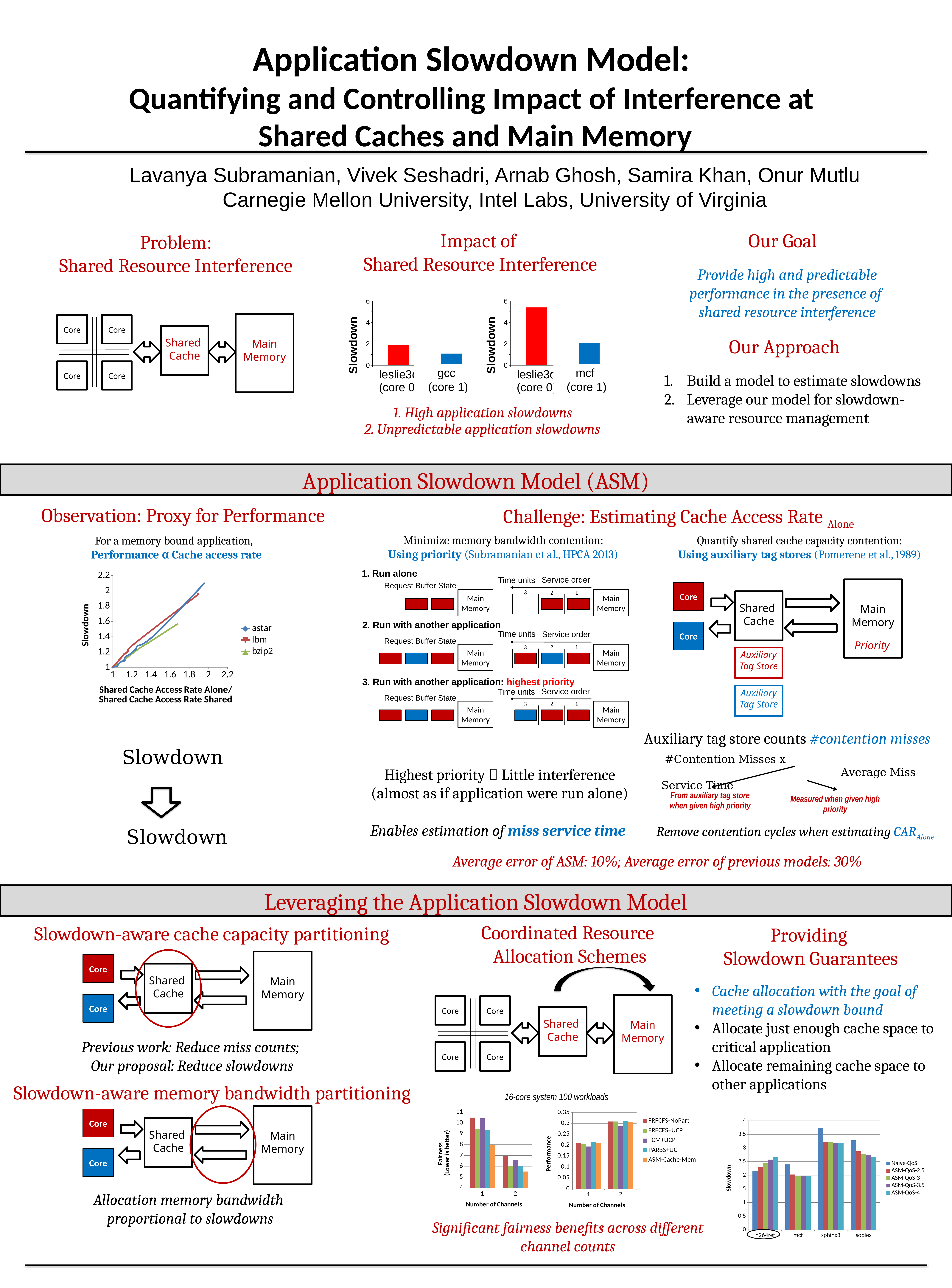
In the 'Providing Slowdown Guarantees' slowdown chart, which application has the highest Naive-QoS slowdown? sphinx3 In the left 'Impact of Shared Resource Interference' chart, which application has the higher slowdown, leslie3d (core 0) or gcc (core 1)? leslie3d (core 0) In the 'Observation: Proxy for Performance' chart, does slowdown rise or fall as the shared cache access rate ratio increases along the x axis? rise In the 'Providing Slowdown Guarantees' slowdown chart, how many application categories are shown on the x axis? 4 In the Fairness (Lower is better) chart under 'Coordinated Resource Allocation Schemes', how many series does the legend list? 5 In the 'Observation: Proxy for Performance' chart, how many series does the legend list? 3 In the Fairness (Lower is better) chart, is the value for FRFCFS-NoPart at 1 channel greater or less than 9? greater In the 'Providing Slowdown Guarantees' slowdown chart, is the Naive-QoS slowdown for mcf greater or less than 3? less In the right 'Impact of Shared Resource Interference' chart (leslie3d and mcf), is the slowdown for leslie3d (core 0) greater or less than 4? greater In the Performance chart under 'Coordinated Resource Allocation Schemes', how many Number of Channels categories are shown on the x axis? 2 What kind of chart is the 'Observation: Proxy for Performance' chart plotting astar, lbm and bzip2? line chart